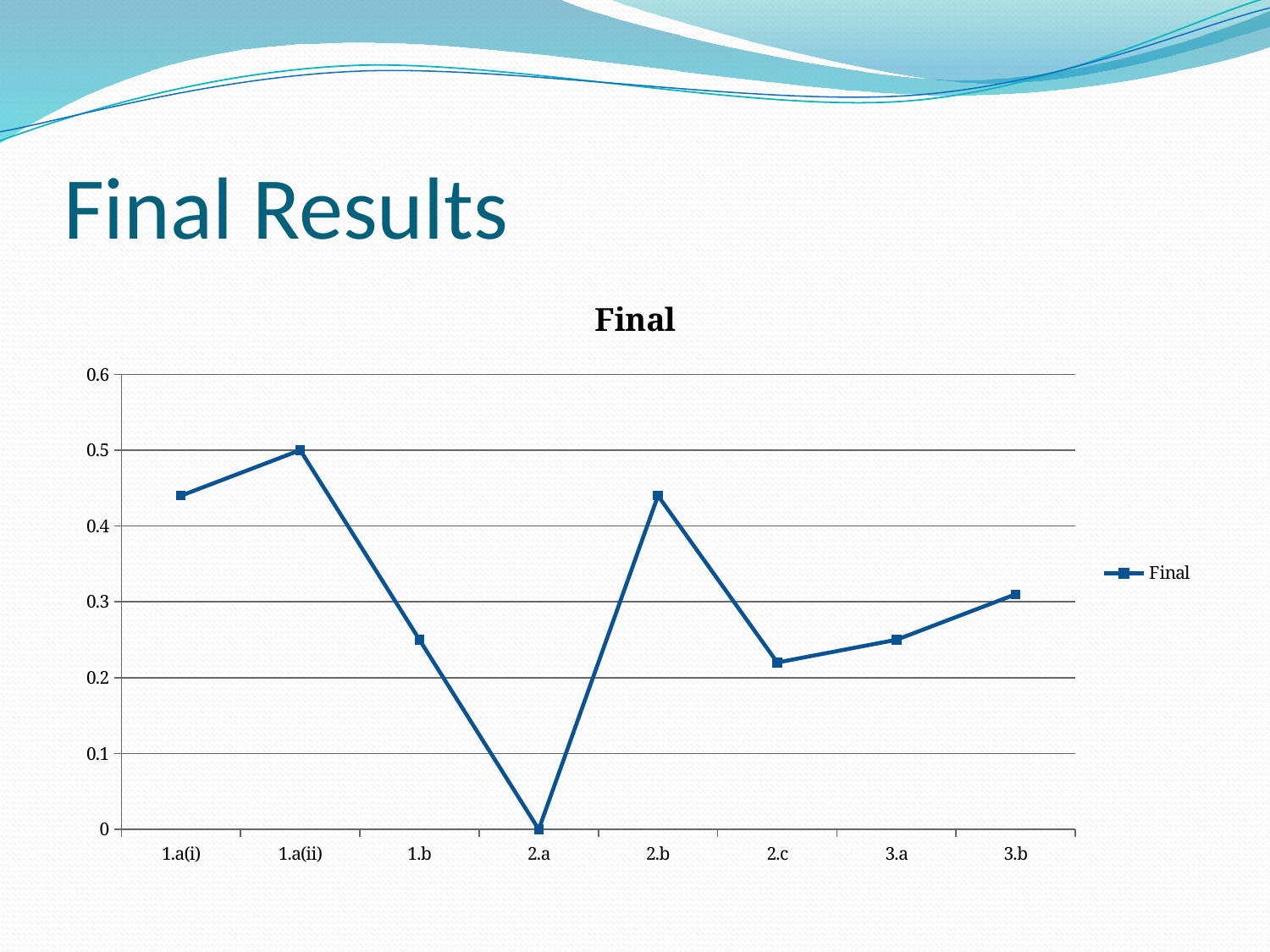
What is the title of the chart? Final Is the value for 1.b greater or less than 0.3? less What is the value for 1.a(ii)? 0.5 Is the value for 1.a(i) greater or less than 0.4? greater Which category has the lowest value? 2.a What type of chart is shown on the slide? line chart Which is larger, the value for 2.c or the value for 3.b? 3.b What is the value for 2.a? 0 How many series does the legend list? 1 What is the difference between the values for 1.a(ii) and 2.a? 0.5 Which category has the highest value? 1.a(ii) How many categories are plotted along the x axis? 8